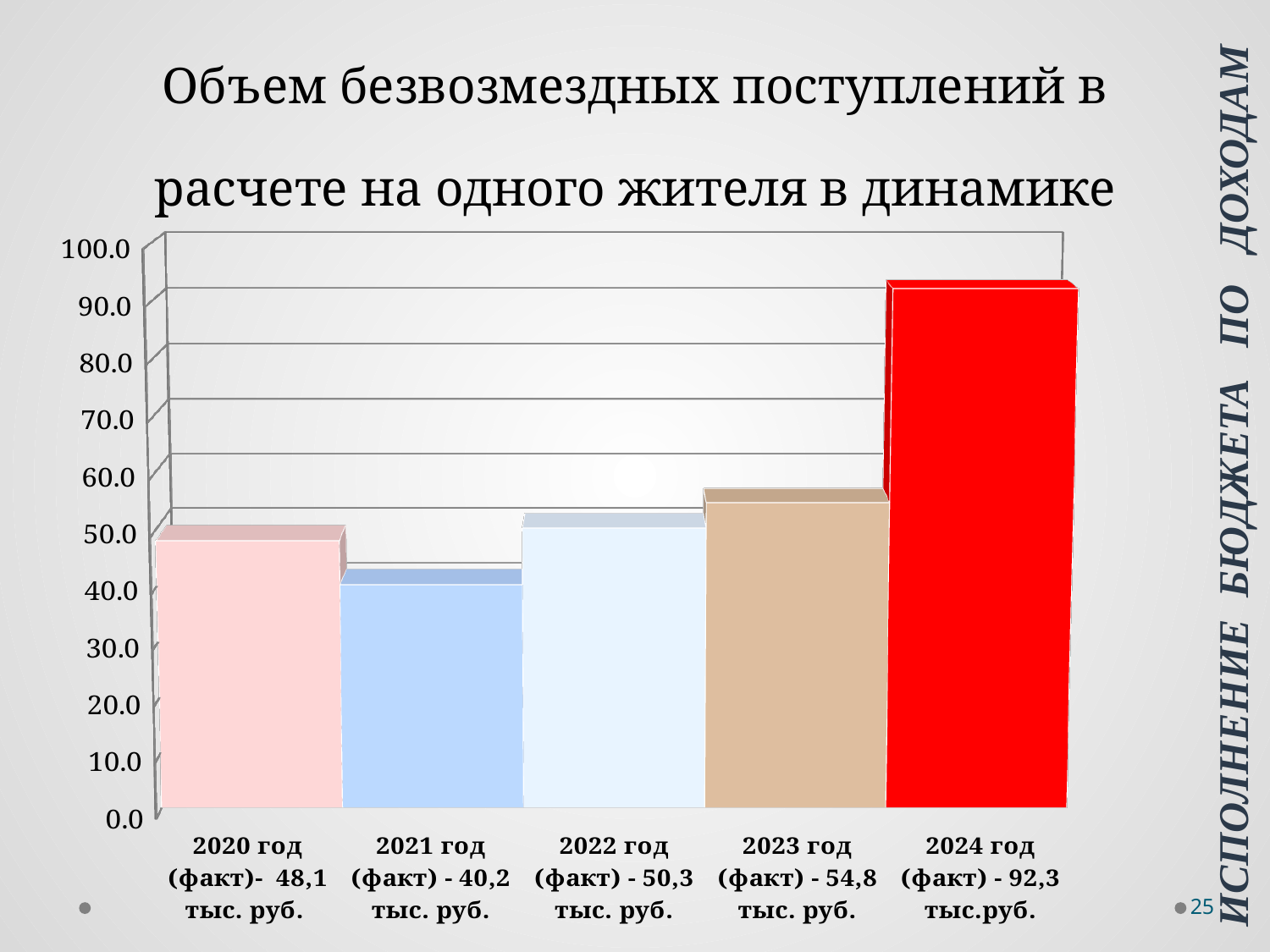
What is the value for 2022 год (факт)? 50,3 тыс. руб. Do the values rise or fall from 2021 год to 2024 год? rise What is the value for 2024 год (факт)? 92,3 тыс.руб. What type of chart is shown on the slide? bar chart What is the value for 2021 год (факт)? 40,2 тыс. руб. Is the value for 2023 год greater or less than 60.0? less What is the title of the chart? Объем безвозмездных поступлений в расчете на одного жителя в динамике Which year has the highest value? 2024 год What is the difference between the values for 2024 год and 2023 год? 37,5 тыс. руб. Which is larger, the value for 2020 год or the value for 2022 год? 2022 год How many bars (years) are shown in the chart? 5 Which year has the lowest value? 2021 год